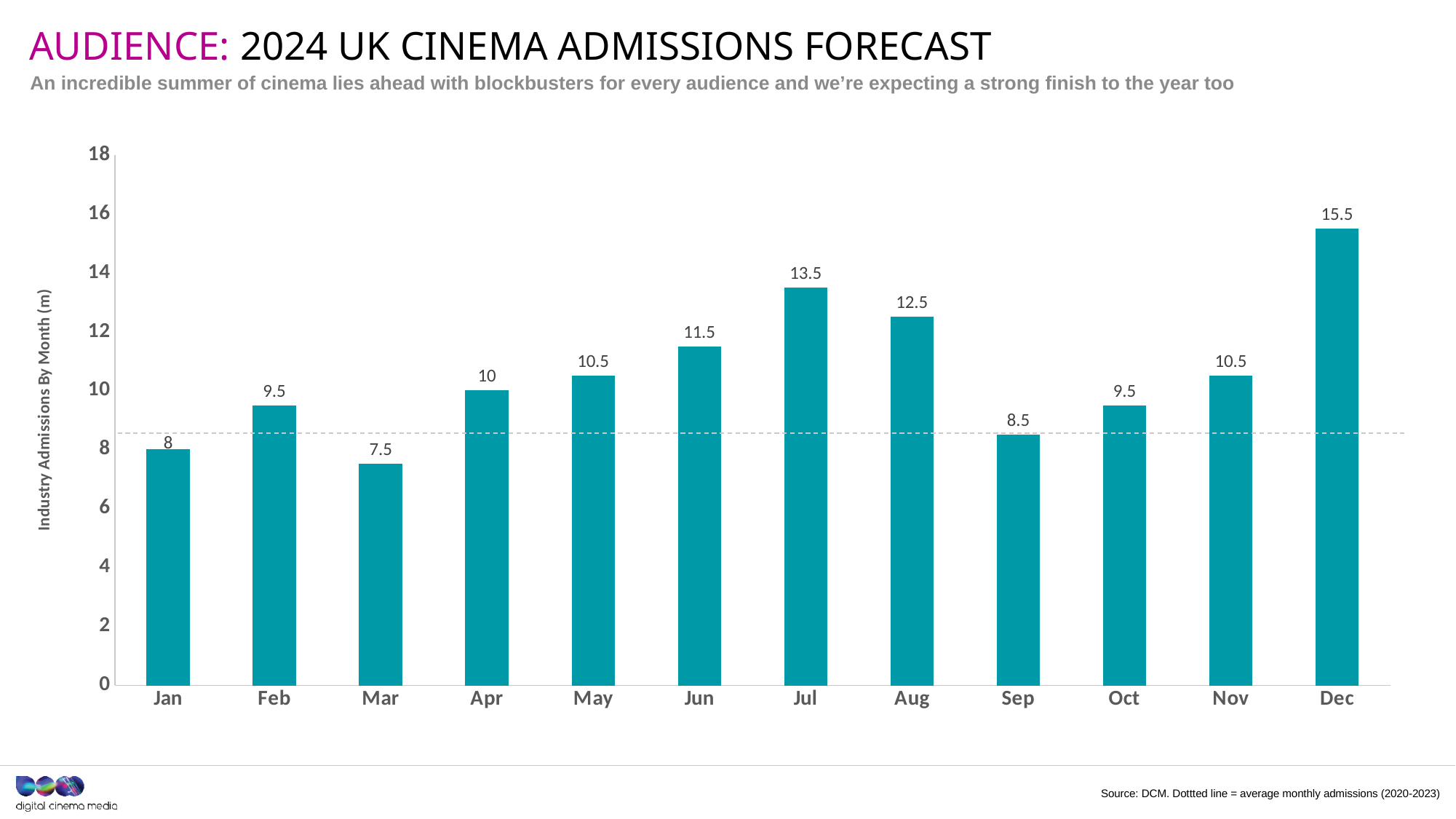
What is the forecast value for Mar? 7.5 What is the difference between the values for Aug and Sep? 4 How many months are shown on the x axis? 12 Is the value for Jan greater or less than 10? less What is the forecast value for Sep? 8.5 Which is larger, the value for Jun or the value for Nov? Jun What kind of chart is shown on the slide? bar chart What is the forecast value for Jul? 13.5 Which month has the highest forecast admissions? Dec What is the difference between the values for Dec and Jul? 2 Which month has the lowest forecast admissions? Mar Do the values rise or fall from Mar to Jul? rise